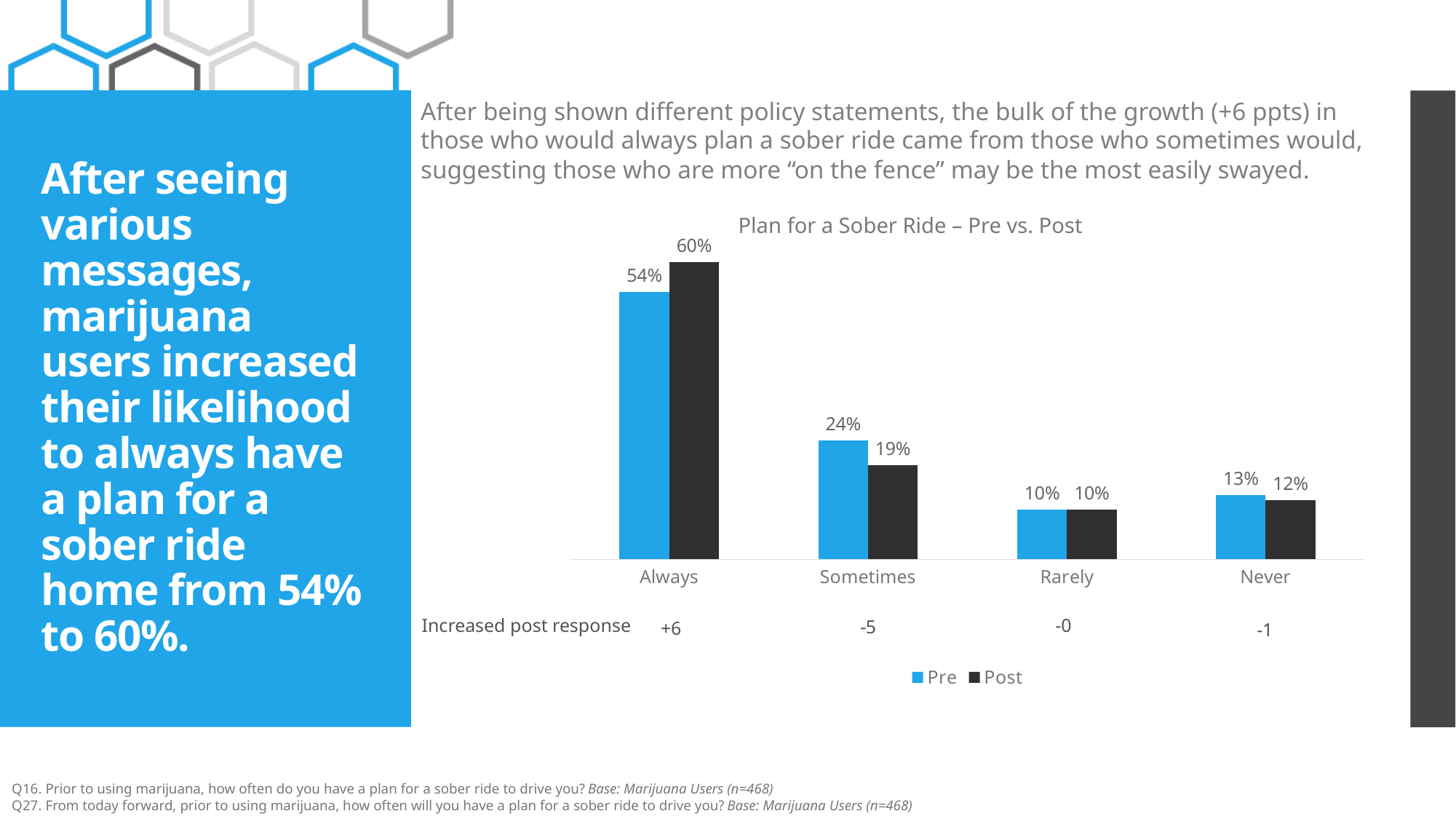
What is the Post value for Always? 60% What is the difference between the Pre and Post values for Sometimes? 5% What is the difference between the Post and Pre values for Always? 6% Which is larger for Sometimes, the Pre value or the Post value? Pre How many series does the legend list? 2 What is the Pre value for Always? 54% Which category has the highest Post value? Always What is the Post value for Sometimes? 19% What is the Pre value for Never? 13% Which category has the lowest Pre value? Rarely How many categories are shown on the x axis? 4 What type of chart is shown? Bar chart